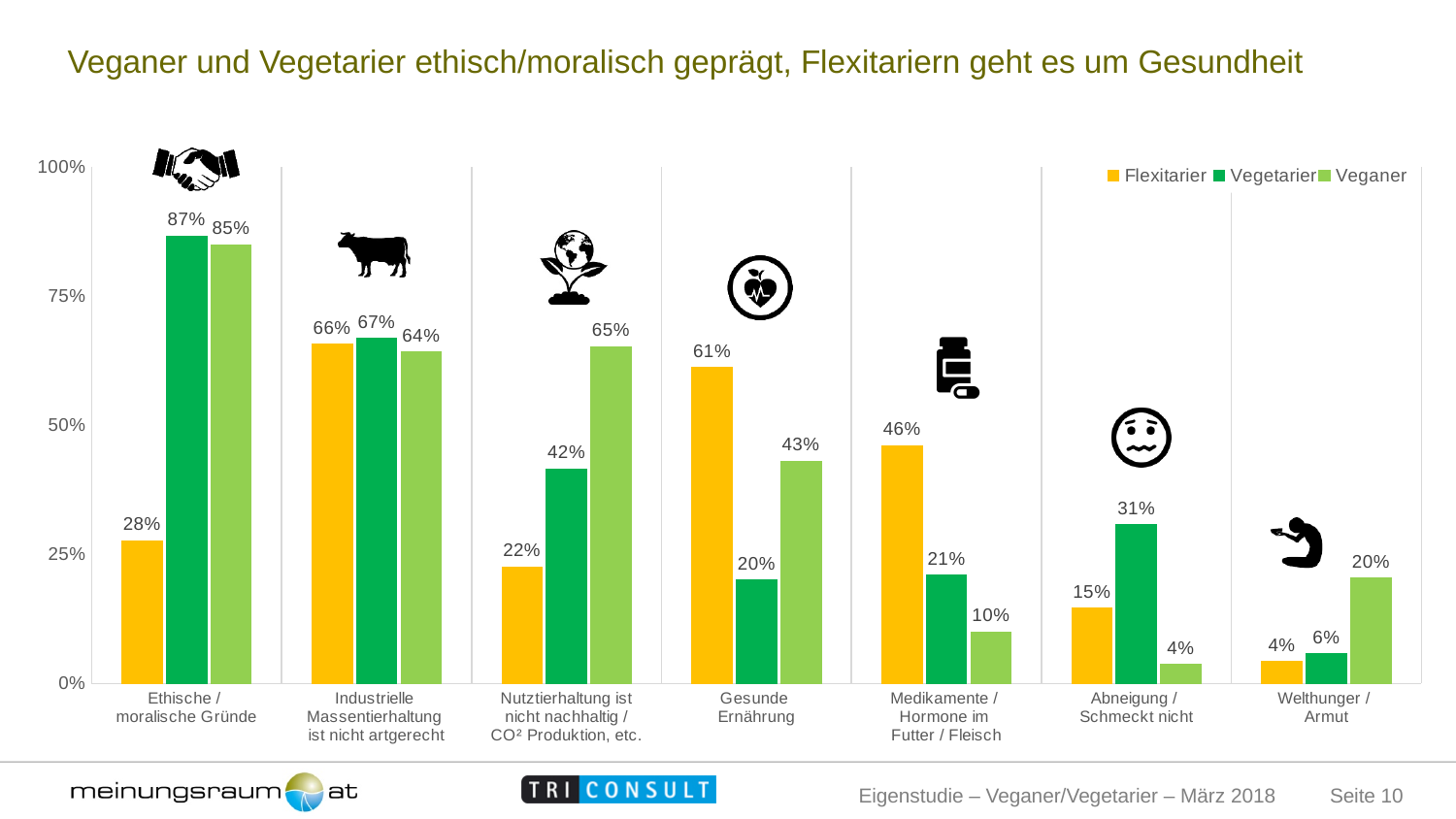
How many series does the legend list? 3 What kind of chart is shown on the slide? Bar chart What is the difference between the Flexitarier and Vegetarier values in the category 'Gesunde Ernährung'? 41% What is the difference between the Veganer and Flexitarier values in the category 'Nutztierhaltung ist nicht nachhaltig / CO² Produktion, etc.'? 43% What is the value for Flexitarier in the category 'Gesunde Ernährung'? 61% What is the value for Vegetarier in the category 'Ethische / moralische Gründe'? 87% Which category has the highest value for Flexitarier? Industrielle Massentierhaltung ist nicht artgerecht Which category has the lowest value for Veganer? Abneigung / Schmeckt nicht How many categories are shown on the x axis? 7 Which series is shown in orange in the legend? Flexitarier What is the value for Veganer in the category 'Welthunger / Armut'? 20% In the category 'Medikamente / Hormone im Futter / Fleisch', which is larger: the Vegetarier value or the Veganer value? Vegetarier